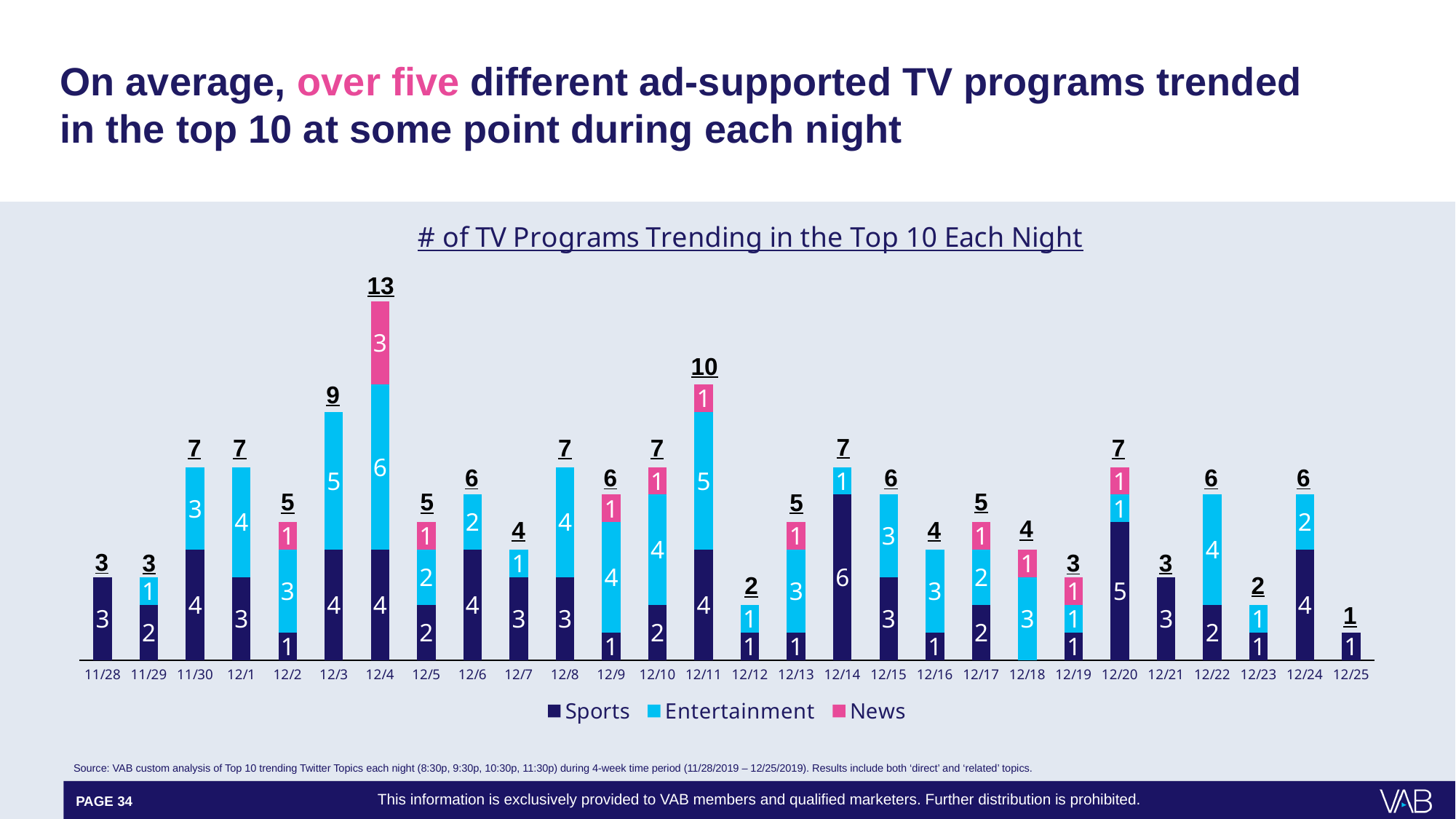
What is the total number of TV programs trending on 12/11? 10 What type of chart is shown on the slide? Stacked bar chart How many Entertainment programs trended on 12/4? 6 Which night had the lowest total number of TV programs trending in the top 10? 12/25 How many News programs trended on 12/4? 3 How many series does the legend list? 3 What is the difference between the total for 12/4 and the total for 12/11? 3 Which night had a higher total, 12/3 or 12/20? 12/3 What is the title of the chart? # of TV Programs Trending in the Top 10 Each Night Which night had the highest total number of TV programs trending in the top 10? 12/4 How many nights (dates) are shown along the x axis? 28 How many Sports programs trended on 12/14? 6